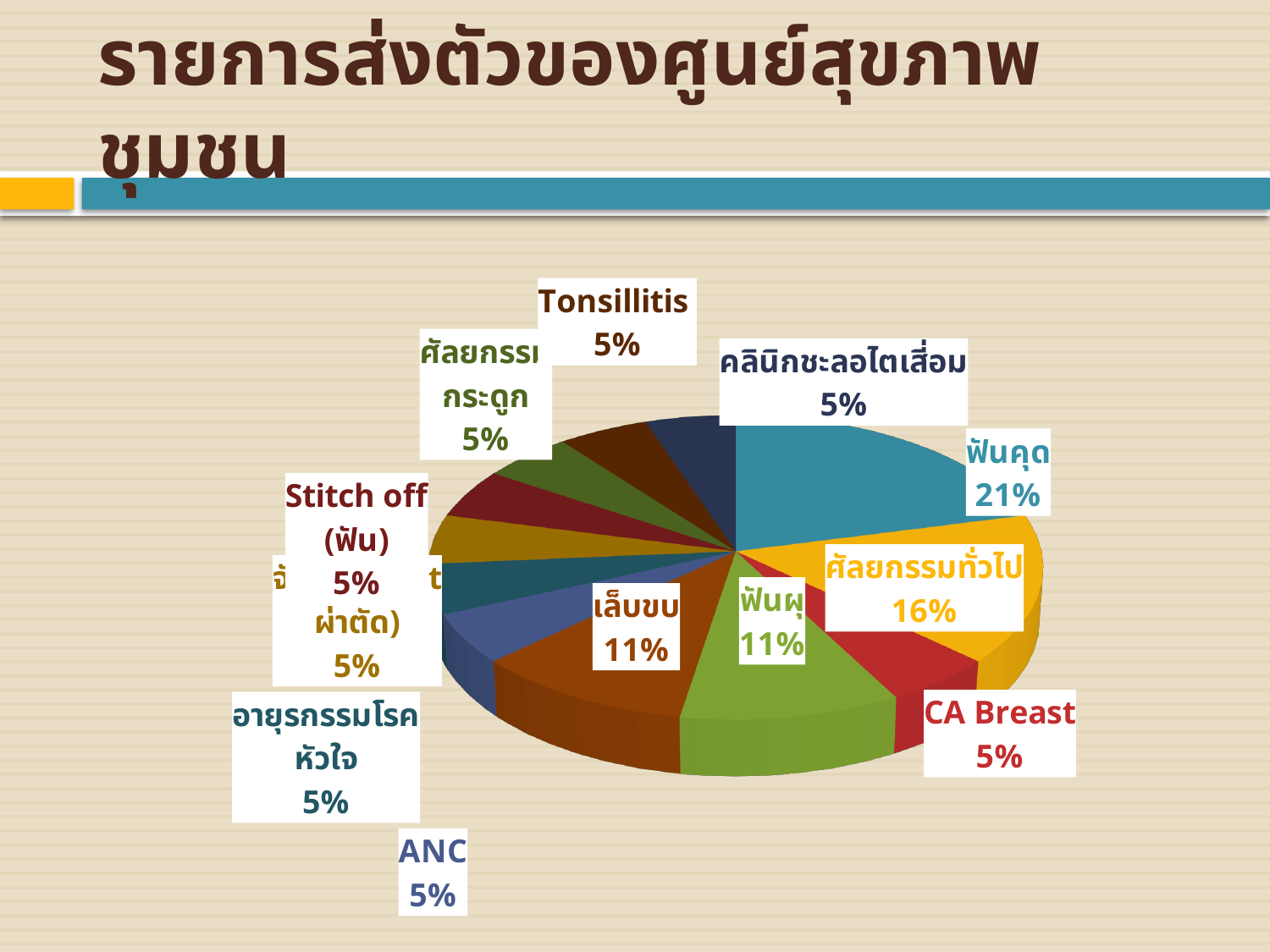
What is the difference in percentage points between เล็บขบ and Tonsillitis? 6 Which is larger, ศัลยกรรมทั่วไป or ฟันผุ? ศัลยกรรมทั่วไป What percentage is shown for เล็บขบ? 11% Which category has the largest slice of the pie? ฟันคุด What is the value shown for ศัลยกรรมทั่วไป? 16% What percentage is shown for CA Breast? 5% What percentage is shown for คลินิกชะลอไตเสื่อม? 5% What share of the pie does ฟันคุด represent? 21% What is the difference in percentage points between ฟันคุด and ศัลยกรรมทั่วไป? 5 What is the value shown for ANC? 5% What is the title of the slide containing the chart? รายการส่งตัวของศูนย์สุขภาพชุมชน What kind of chart is shown on the slide? pie chart